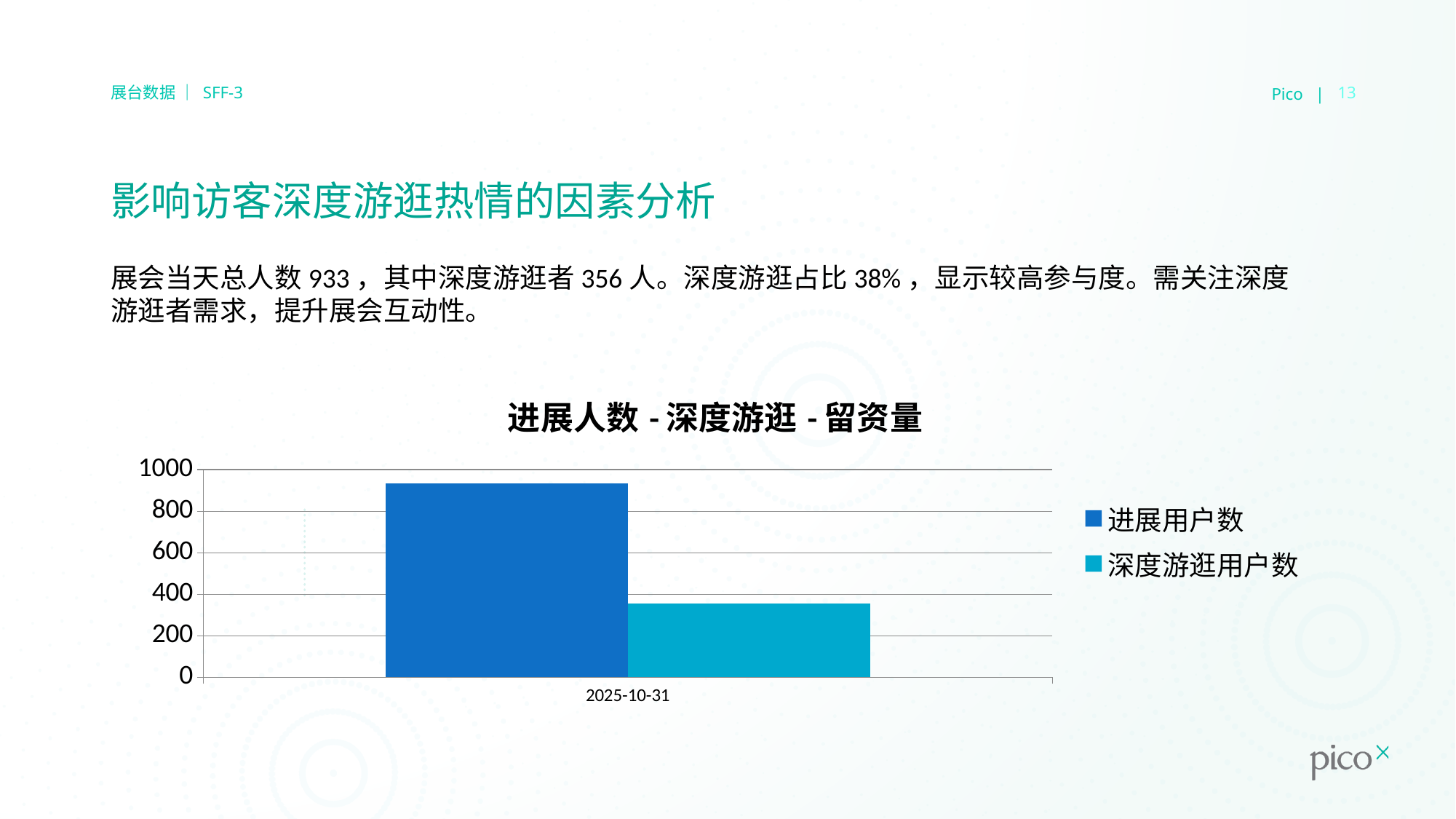
How many series does the chart legend list? 2 What is the category label on the x axis of the chart? 2025-10-31 Is the value for 进展用户数 greater or less than 1000? less Is the value for 深度游逛用户数 greater or less than 400? less Is the value for 深度游逛用户数 greater or less than 200? greater Which series has the higher bar in the chart, 进展用户数 or 深度游逛用户数? 进展用户数 What kind of chart is shown on the slide? bar chart Which series has the lowest bar in the chart? 深度游逛用户数 Which series has the highest bar in the chart? 进展用户数 What is the title of the chart? 进展人数 - 深度游逛 - 留资量 How many categories are shown on the x axis of the chart? 1